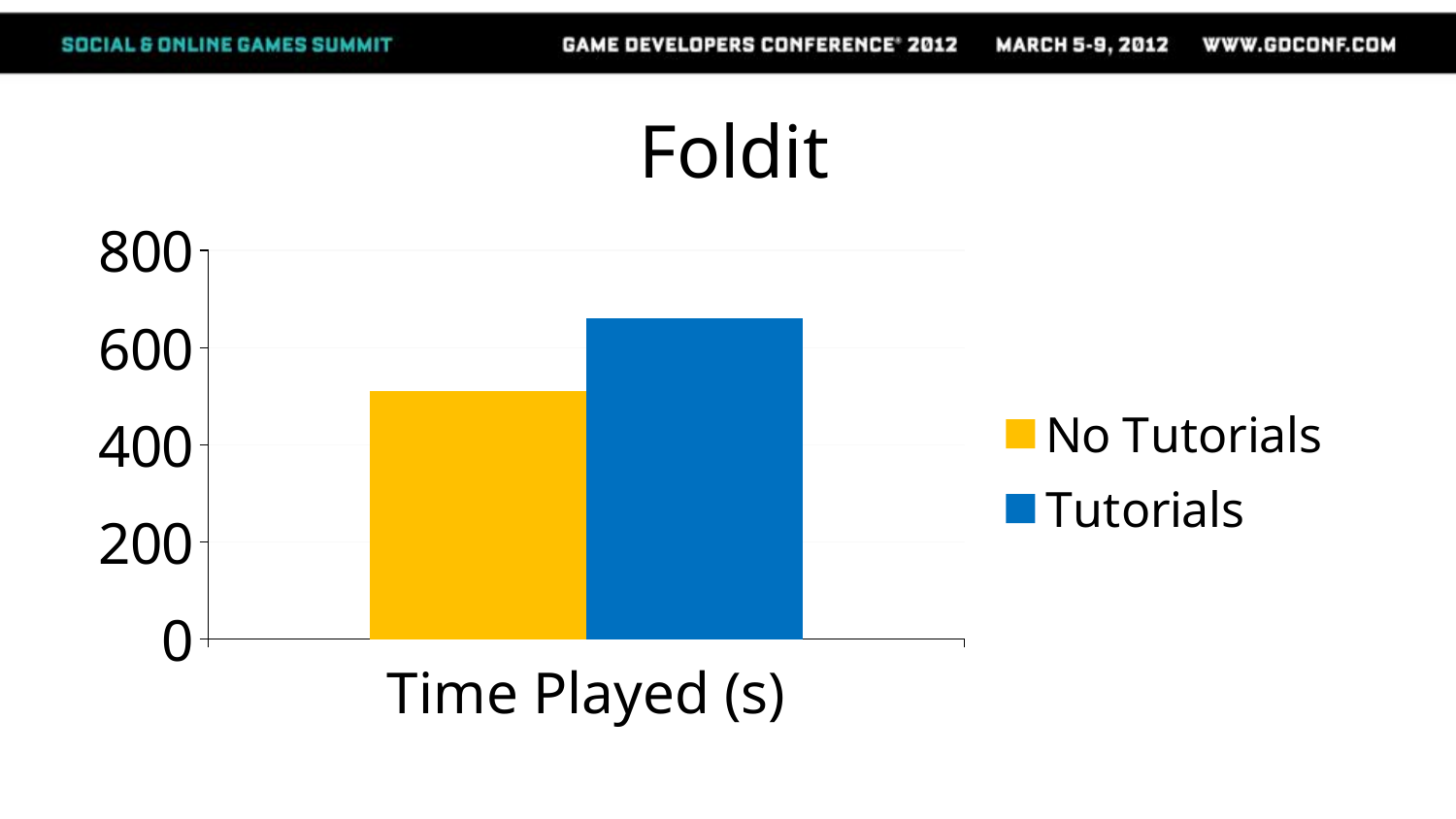
What kind of chart is shown on the slide? bar chart Which series has the lower value for Time Played (s)? No Tutorials Is the value for Tutorials greater or less than 800? less How many categories are shown on the x axis? 1 Which series has the higher value for Time Played (s)? Tutorials What is the title of the chart? Foldit Which is larger, the value for Tutorials or the value for No Tutorials? Tutorials Is the value for Tutorials greater or less than 600? greater How many series does the legend list? 2 What is the label on the x axis of the chart? Time Played (s) Is the value for No Tutorials greater or less than 600? less